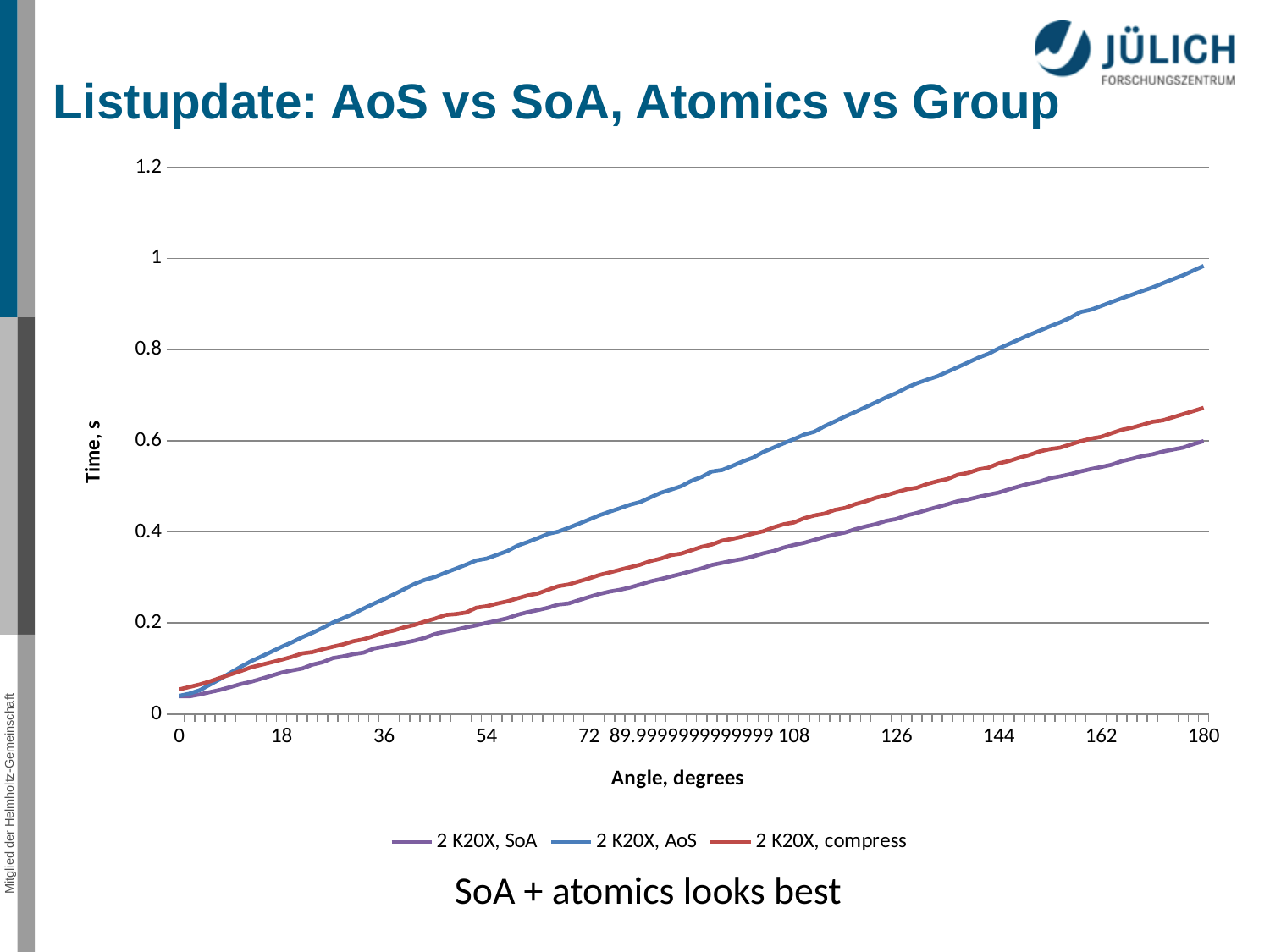
Which series has the highest time at 180 degrees? 2 K20X, AoS Is the value for 2 K20X, compress at 180 degrees greater or less than 0.6? greater How many series does the legend list? 3 At 180 degrees, which is larger: the time for 2 K20X, AoS or for 2 K20X, SoA? 2 K20X, AoS At 18 degrees, which is larger: the time for 2 K20X, compress or for 2 K20X, SoA? 2 K20X, compress What kind of chart is shown on the slide? line chart What is the title of the x axis? Angle, degrees What is the title of the y axis? Time, s Is the value for 2 K20X, SoA at 180 degrees greater or less than 0.8? less Is the value for 2 K20X, AoS at 180 degrees greater or less than 0.8? greater Which series has the lowest time at 180 degrees? 2 K20X, SoA Do the values for the 2 K20X, AoS series rise or fall as the angle increases? rise